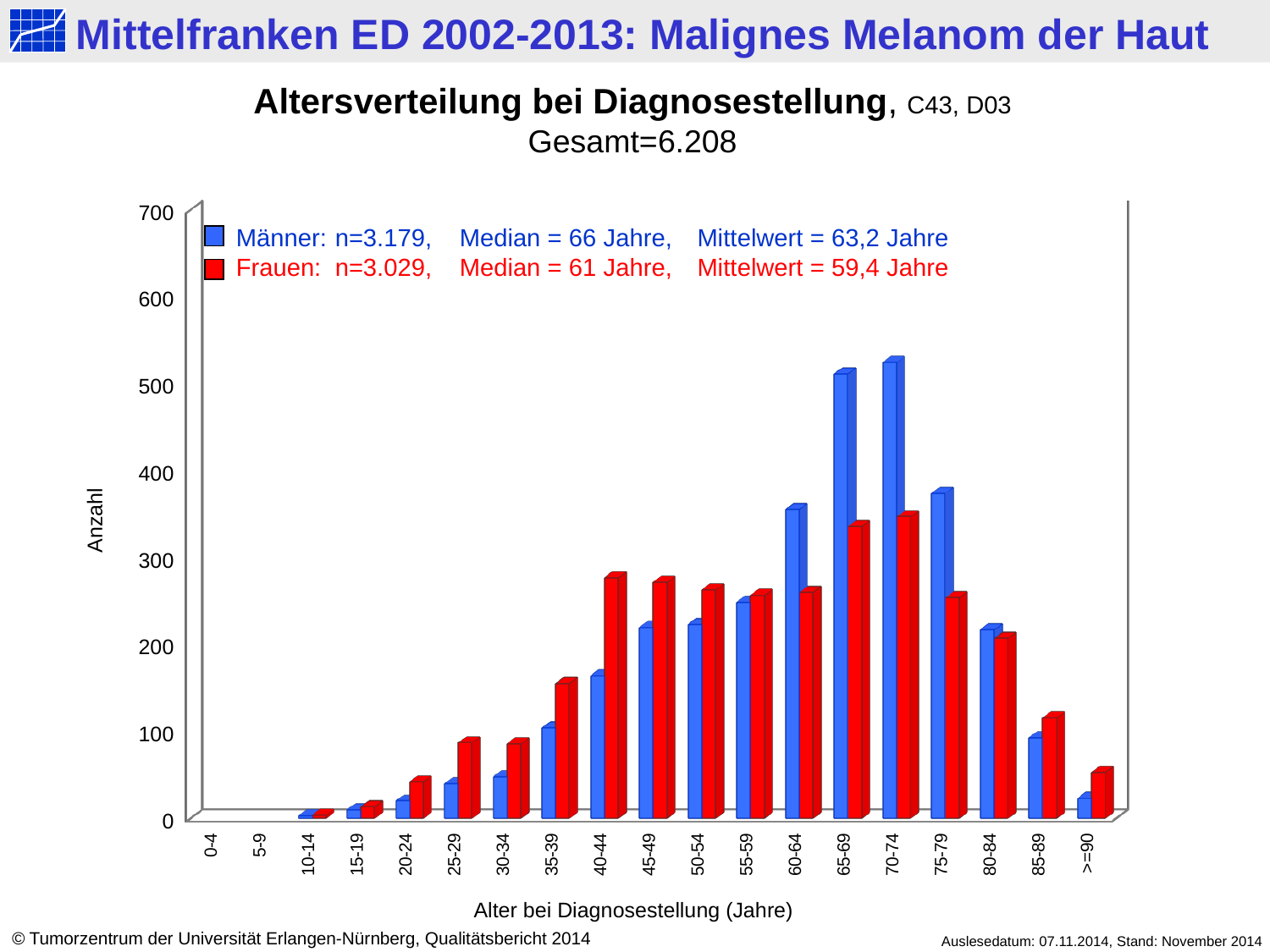
In the 40-44 age group, which series has the larger value, Männer or Frauen? Frauen What kind of chart is shown on the slide? bar chart Do the Männer values rise or fall from the 70-74 age group to the >=90 age group? fall How many age groups are shown on the x axis? 19 Is the Männer value for the 60-64 age group greater or less than 300? greater What is the total number of cases (Gesamt) stated on the slide? 6.208 According to the legend, what is the median age for Männer? 66 Jahre Is the Männer value for the 65-69 age group greater or less than 500? greater How many series does the legend list? 2 In the 65-69 age group, which series has the larger value, Männer or Frauen? Männer Is the Frauen value for the 75-79 age group greater or less than 300? less